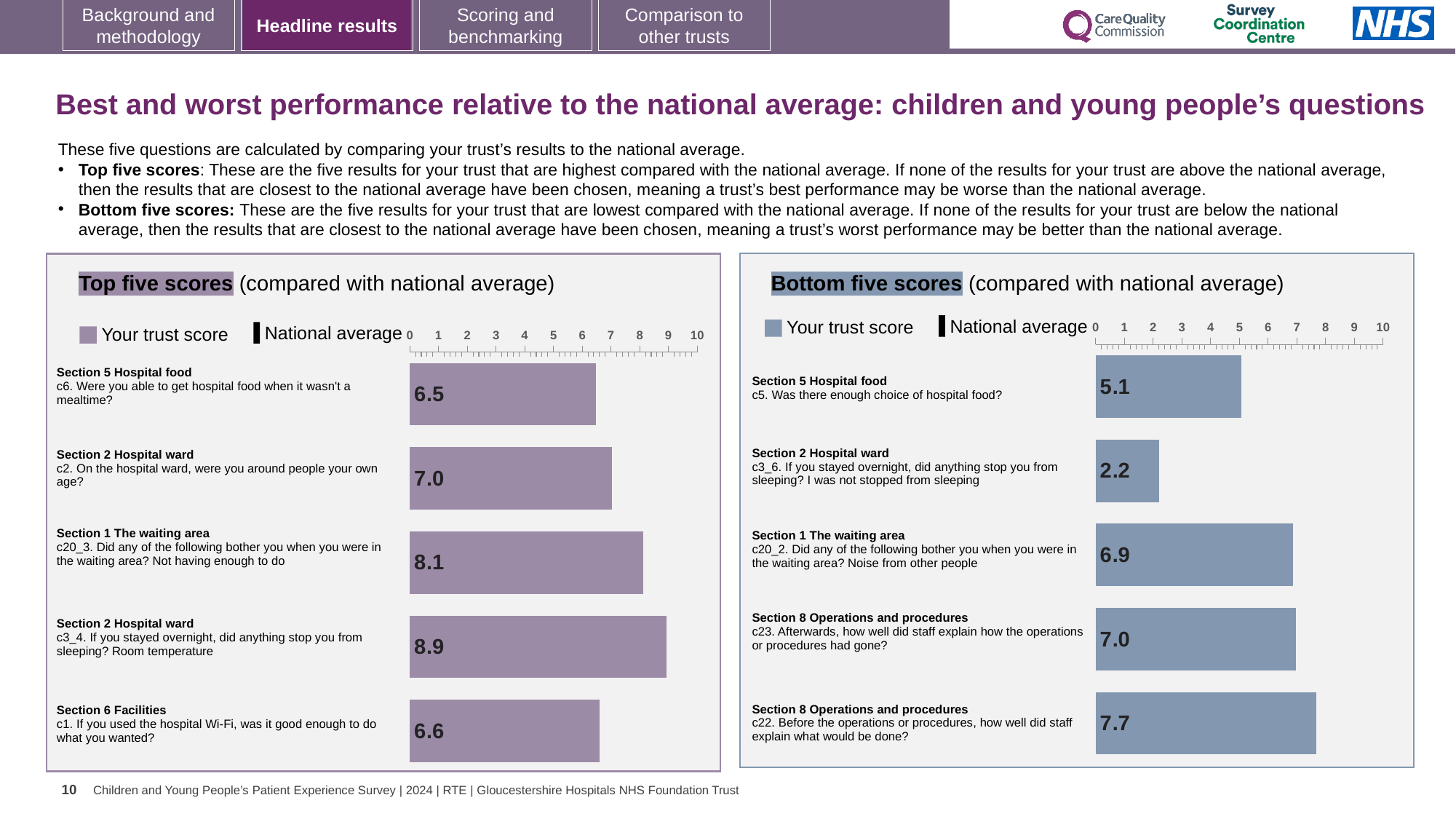
In the Top five scores chart, is the trust score for c20_3 (Not having enough to do) greater or less than 7? greater In the Bottom five scores chart, which question has the lowest trust score? c3_6 (I was not stopped from sleeping) In the Top five scores chart, what is the trust score for c1 (hospital Wi-Fi)? 6.6 In the Bottom five scores chart, which has the larger trust score: c22 or c23? c22 How many series does the legend of the Top five scores chart list? 2 In the Top five scores chart, which question has the highest trust score? c3_4 (Room temperature) In the Bottom five scores chart, which question has the highest trust score? c22 (Before the operations or procedures, how well did staff explain what would be done?) How many questions are shown in the Bottom five scores chart? 5 In the Bottom five scores chart, what is the trust score for c3_6 (I was not stopped from sleeping)? 2.2 In the Top five scores chart, what is the difference between the trust scores for c3_4 (Room temperature) and c6 (hospital food when it wasn't a mealtime)? 2.4 What type of chart is the Top five scores chart? Bar chart In the Top five scores chart, what is the trust score for c3_4 (did anything stop you from sleeping? Room temperature)? 8.9